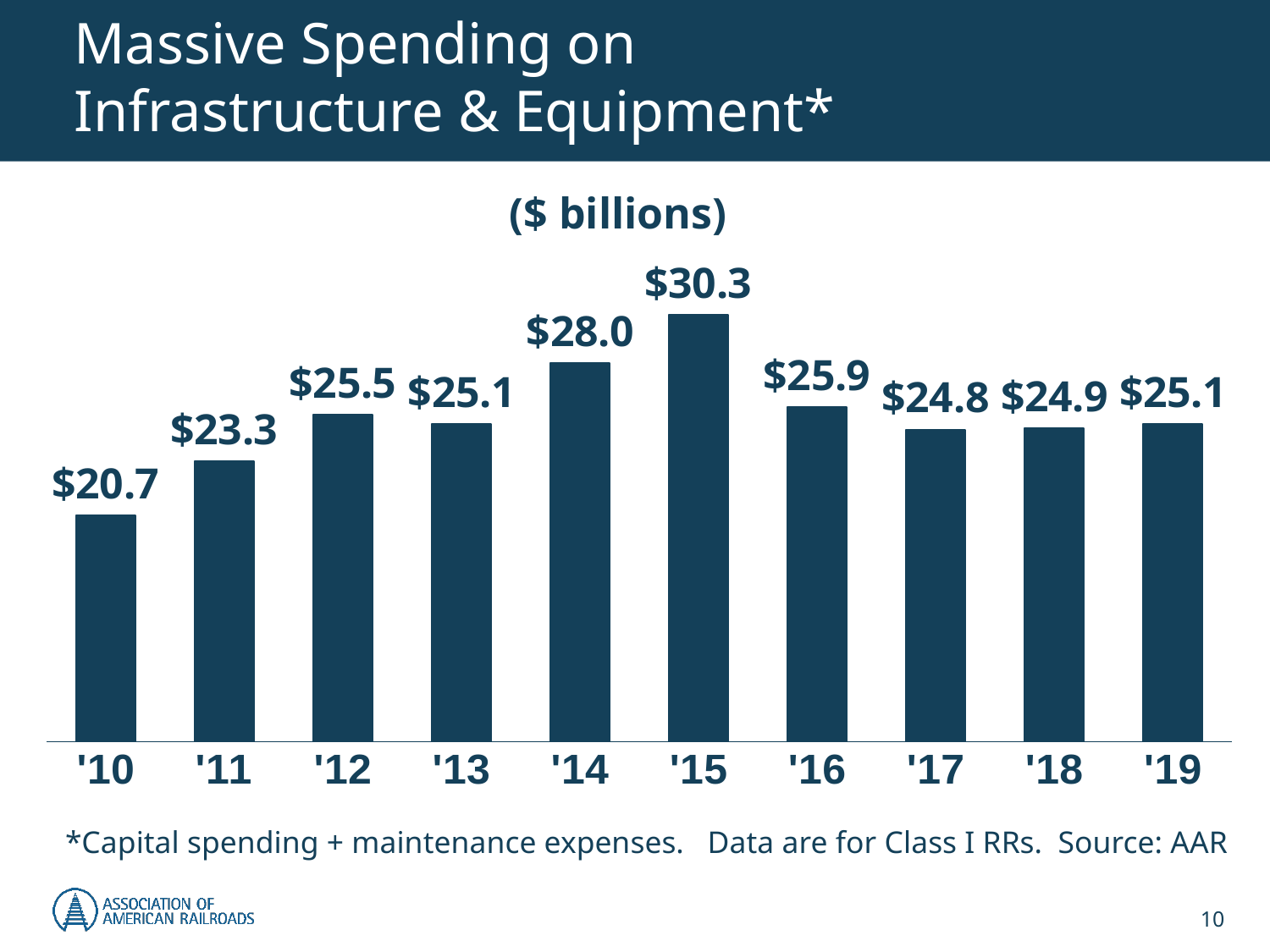
What is the difference between the values for '14 and '13? $2.9 What kind of chart is shown on the slide? bar chart Which year has the lowest value? '10 Which year has the highest value? '15 Do the values rise or fall from '10 to '15? rise overall (with a small dip in '13) What is the value for '10? $20.7 What is the value for '17? $24.8 What is the difference between the values for '15 and '10? $9.6 Which is larger, the value for '12 or the value for '16? '16 How many years are shown on the x axis? 10 What unit is given in the chart's subtitle? $ billions What is the value for '15? $30.3